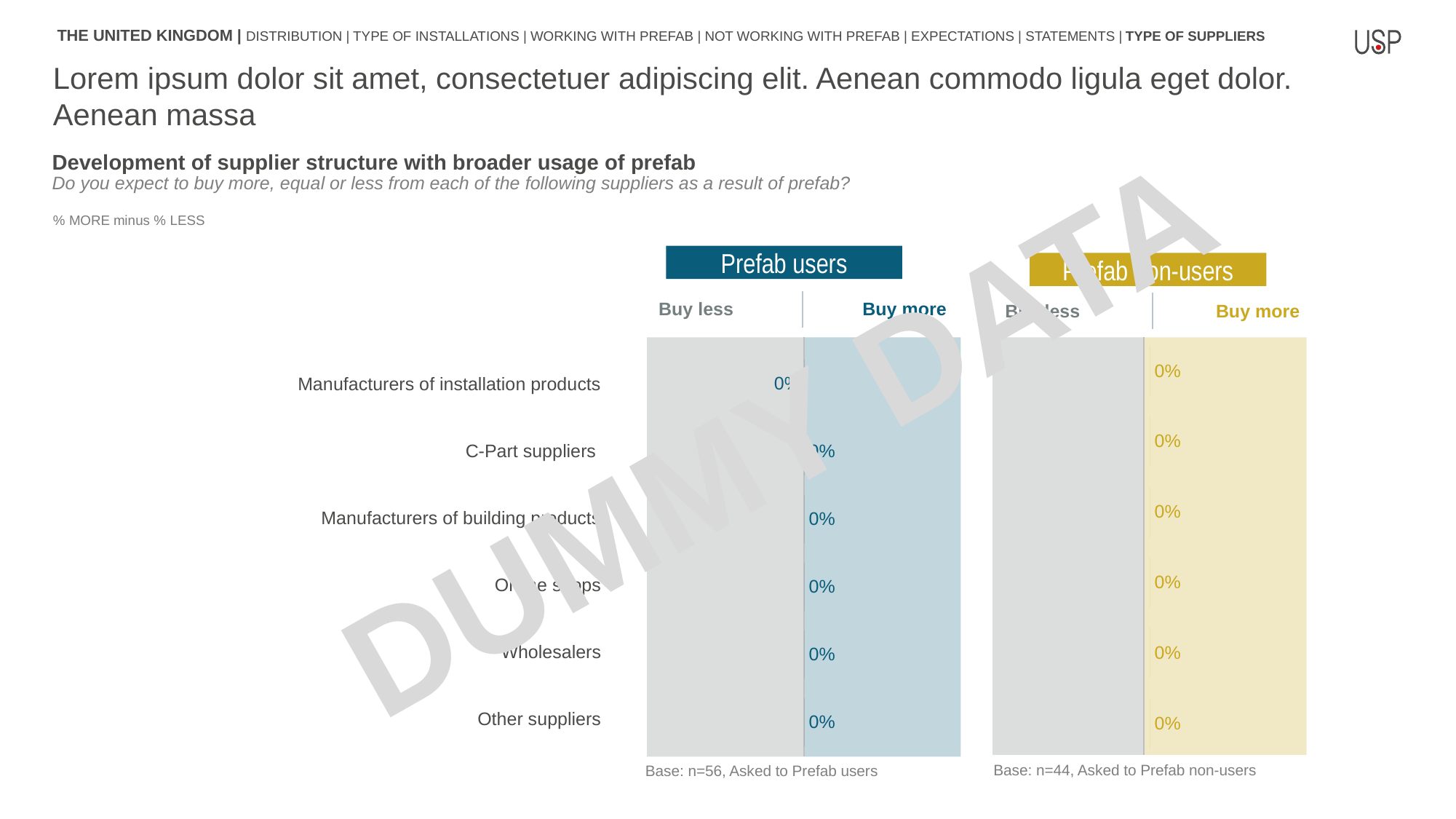
In the Prefab users chart, what is the value for Wholesalers? 0% In the Prefab non-users chart, what is the value for Other suppliers? 0% In the Prefab users chart, what is the value for Manufacturers of building products? 0% In the Prefab non-users chart, what is the value for C-Part suppliers? 0% What is the difference between the Prefab users value for Wholesalers and the Prefab non-users value for Wholesalers? 0% In the Prefab users chart, what is the value for Other suppliers? 0% How many supplier categories are listed in the Prefab non-users chart? 6 How many supplier categories are listed in the Prefab users chart? 6 In the Prefab non-users chart, what is the value for Manufacturers of installation products? 0% What is the base size stated for the Prefab non-users chart? n=44 What is the title of the chart section on the slide? Development of supplier structure with broader usage of prefab What kind of chart is used to show the Prefab users data? Bar chart